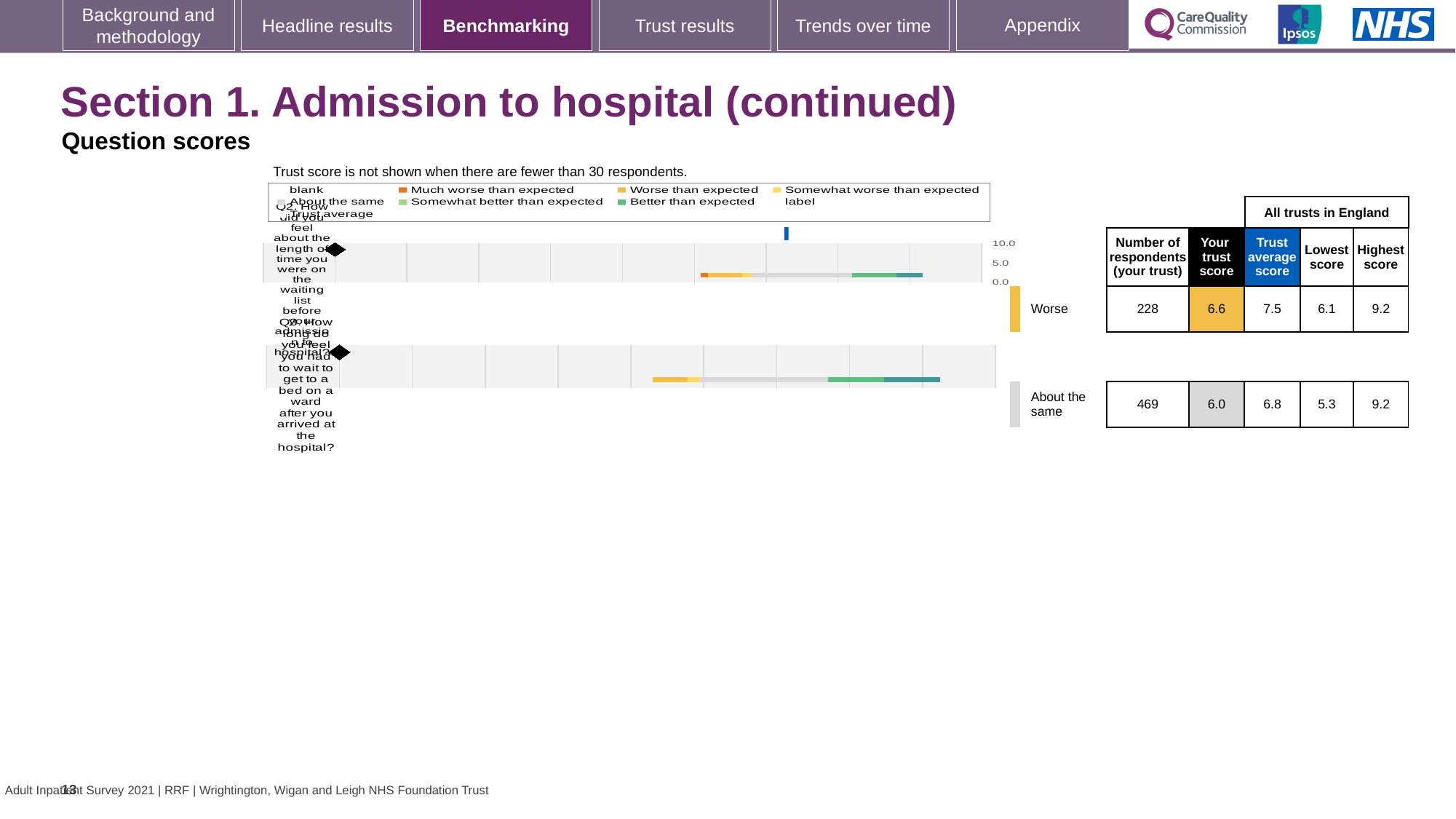
How many questions are plotted in the chart? 2 What is the highest score among all trusts in England for Q3? 9.2 Which question has the lower 'Lowest score' across all trusts in England? Q3 What benchmark category is shown for Q2? Worse How many respondents answered Q3 for this trust? 469 What is the trust score for Q3 (wait to get to a bed on a ward after arriving at the hospital)? 6.0 What is the difference between the trust average score and this trust's score for Q2? 0.9 What is the trust average score across all trusts in England for Q2? 7.5 What is the trust score for Q2 (length of time on the waiting list before admission)? 6.6 Which question has the higher trust score, Q2 or Q3? Q2 What is the maximum value shown on the chart's score axis? 10.0 What is the lowest score among all trusts in England for Q2? 6.1